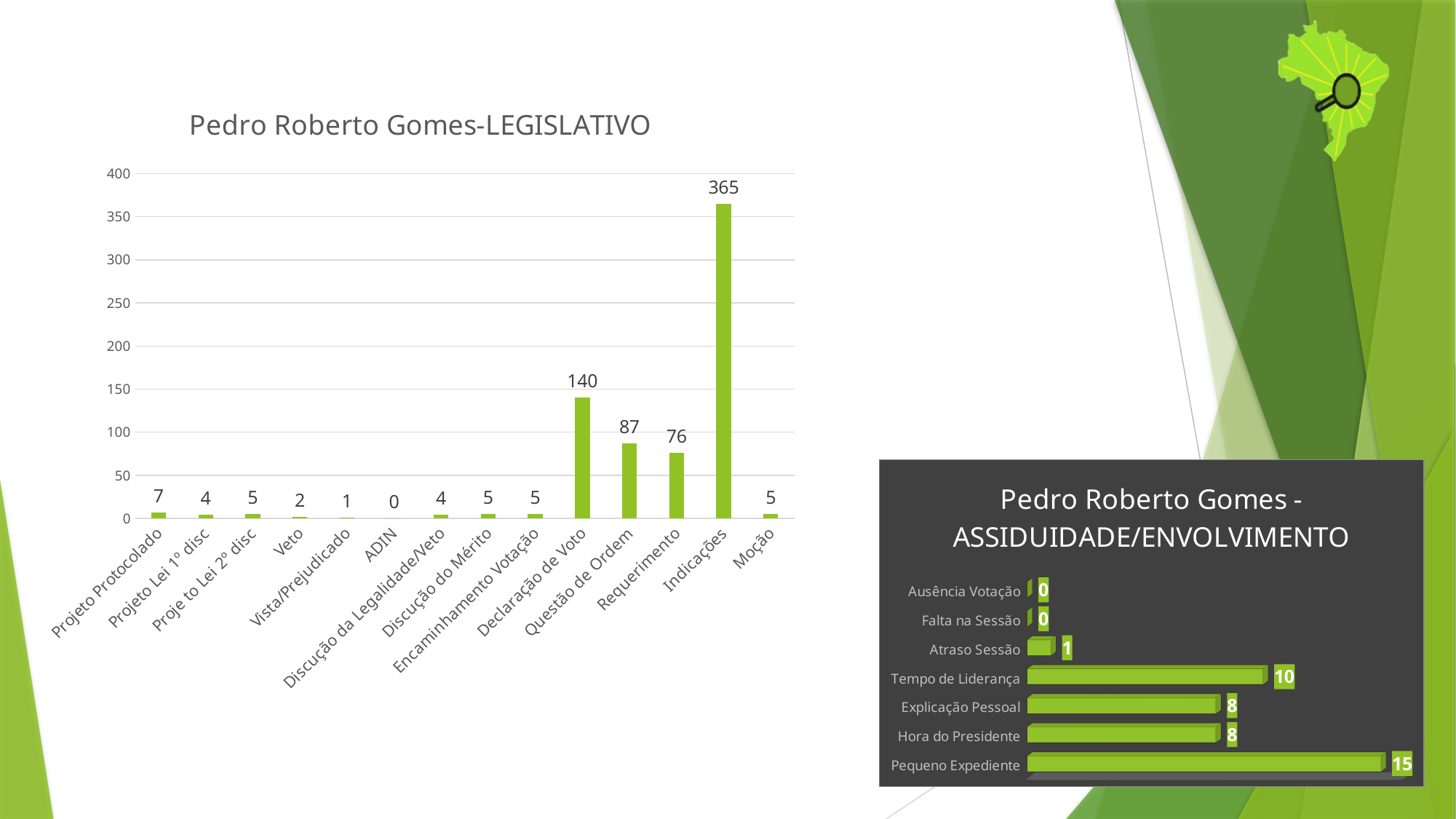
In the 'Pedro Roberto Gomes-LEGISLATIVO' chart, what is the value for Declaração de Voto? 140 In the 'Pedro Roberto Gomes-LEGISLATIVO' chart, which category has the lowest value? ADIN In the 'Pedro Roberto Gomes-LEGISLATIVO' chart, which category has the highest value? Indicações In the 'Pedro Roberto Gomes-LEGISLATIVO' chart, what is the difference between Questão de Ordem and Requerimento? 11 In the 'Pedro Roberto Gomes-LEGISLATIVO' chart, which is larger, Declaração de Voto or Questão de Ordem? Declaração de Voto How many categories are shown in the 'Pedro Roberto Gomes-LEGISLATIVO' chart? 14 In the 'Pedro Roberto Gomes - ASSIDUIDADE/ENVOLVIMENTO' chart, which category has the highest value? Pequeno Expediente In the 'Pedro Roberto Gomes-LEGISLATIVO' chart, what is the value for Indicações? 365 In the 'Pedro Roberto Gomes - ASSIDUIDADE/ENVOLVIMENTO' chart, what is the value for Pequeno Expediente? 15 What kind of chart is the 'Pedro Roberto Gomes-LEGISLATIVO' chart? Bar chart How many categories are shown in the 'Pedro Roberto Gomes - ASSIDUIDADE/ENVOLVIMENTO' chart? 7 In the 'Pedro Roberto Gomes - ASSIDUIDADE/ENVOLVIMENTO' chart, what is the value for Tempo de Liderança? 10